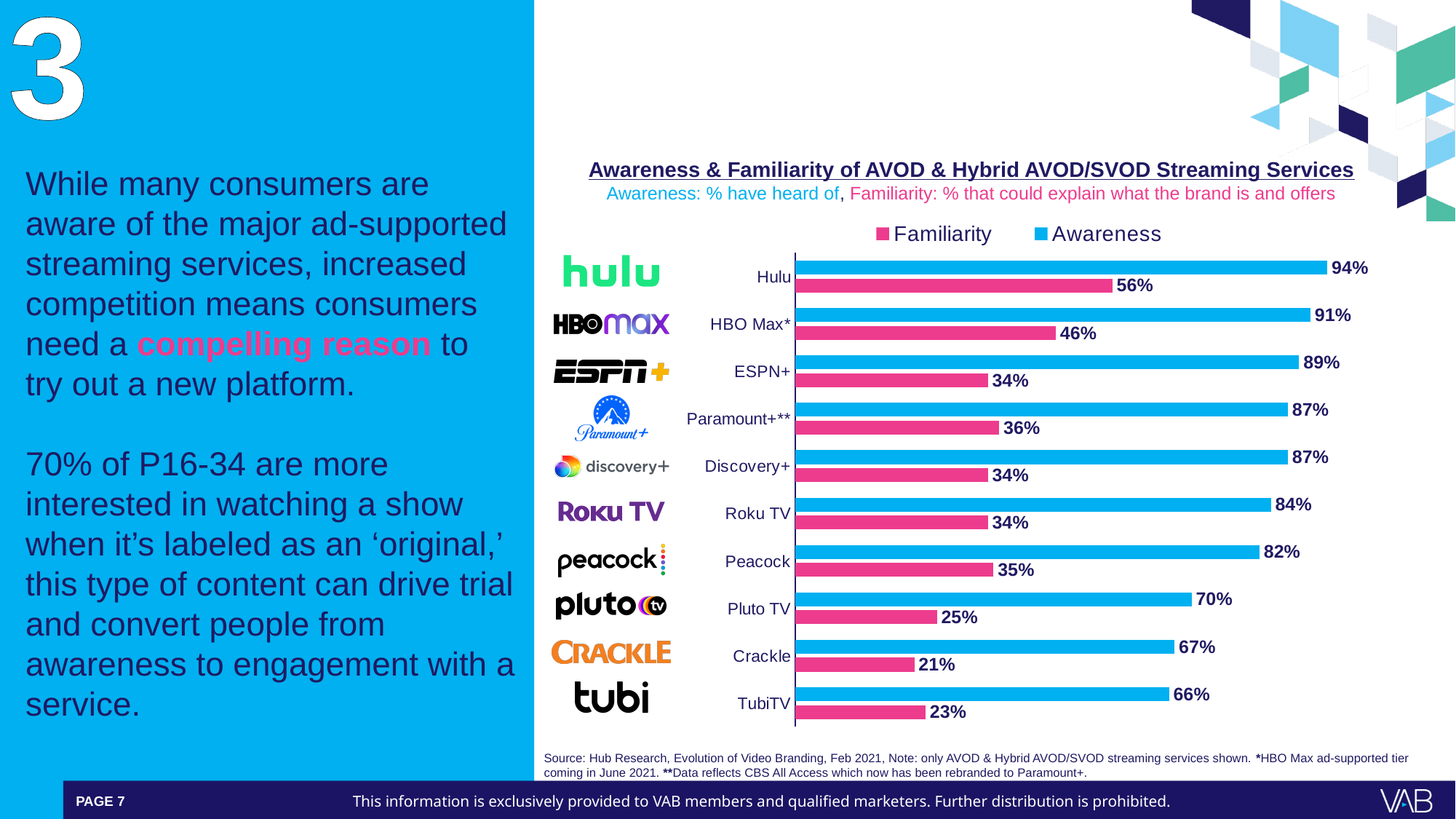
What is the Awareness value for Hulu? 94% Which service has the highest Awareness value? Hulu Which colour represents the Familiarity series in the chart? Pink Which service has the lowest Familiarity value? Crackle What is the difference between the Awareness values for ESPN+ and TubiTV? 23% What is the Familiarity value for Pluto TV? 25% Which is larger, the Familiarity value for Peacock or the Familiarity value for Crackle? Peacock What kind of chart is shown on the slide? Bar chart What is the difference between the Awareness and Familiarity values for Hulu? 38% How many series does the legend list? 2 How many streaming services are shown in the chart? 10 What is the Familiarity value for HBO Max*? 46%